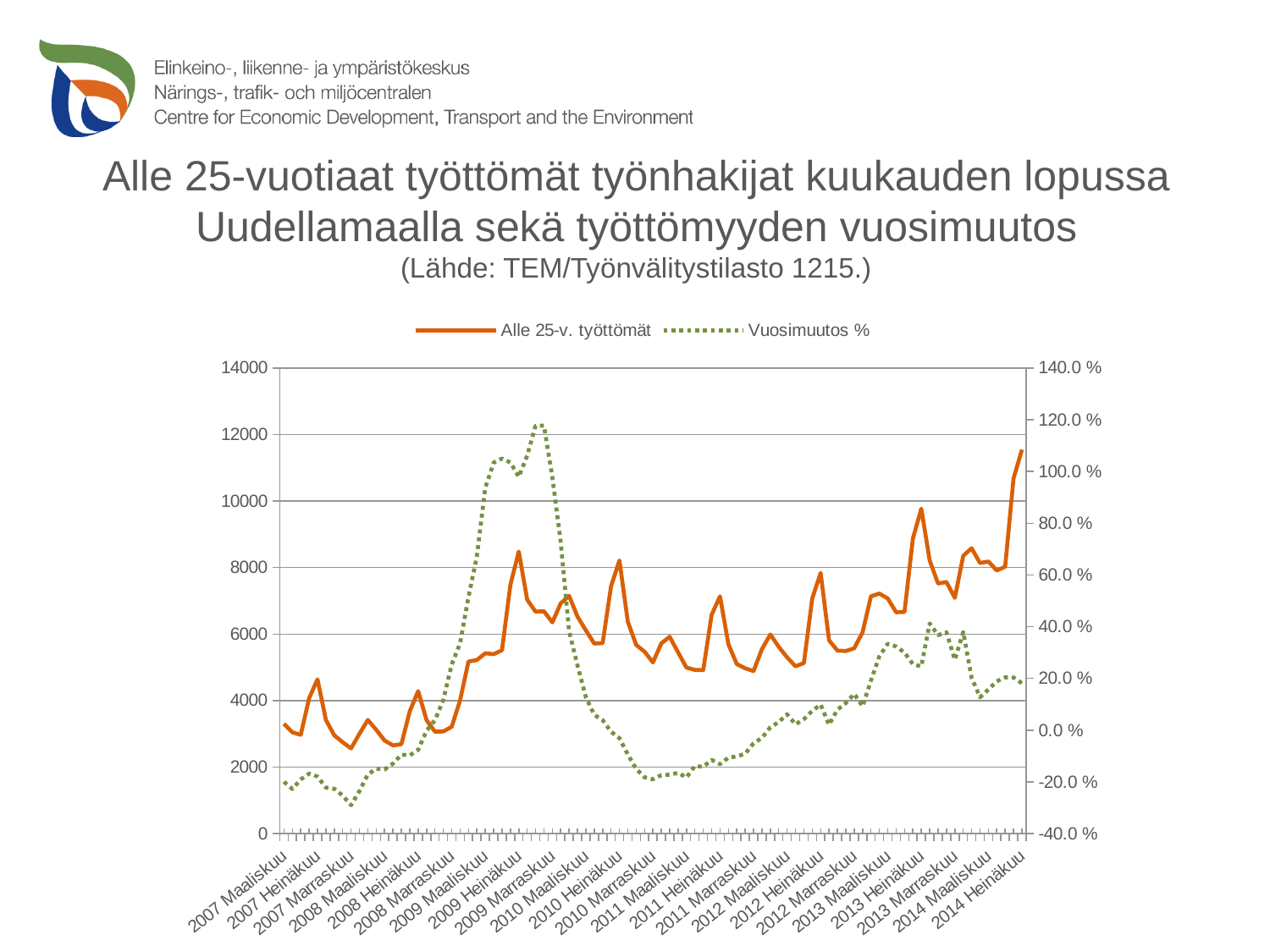
Is the Vuosimuutos % value at 2010 Marraskuu greater or less than 0.0 %? less Which is larger: the Alle 25-v. työttömät value at 2014 Heinäkuu or at 2007 Maaliskuu? 2014 Heinäkuu What are the two series named in the legend? Alle 25-v. työttömät and Vuosimuutos % Does the Vuosimuutos % line rise or fall between 2009 Marraskuu and 2010 Marraskuu? fall Is the value of Alle 25-v. työttömät at 2009 Heinäkuu greater or less than 6000? greater At which x-axis label does the Alle 25-v. työttömät line reach its highest value? 2014 Heinäkuu What kind of chart is shown on the slide? Line chart Is the value of Alle 25-v. työttömät at 2007 Maaliskuu greater or less than 4000? less What is the highest value shown on the right-hand axis? 140.0 % How many category labels are shown along the x axis? 23 How many series does the legend list? 2